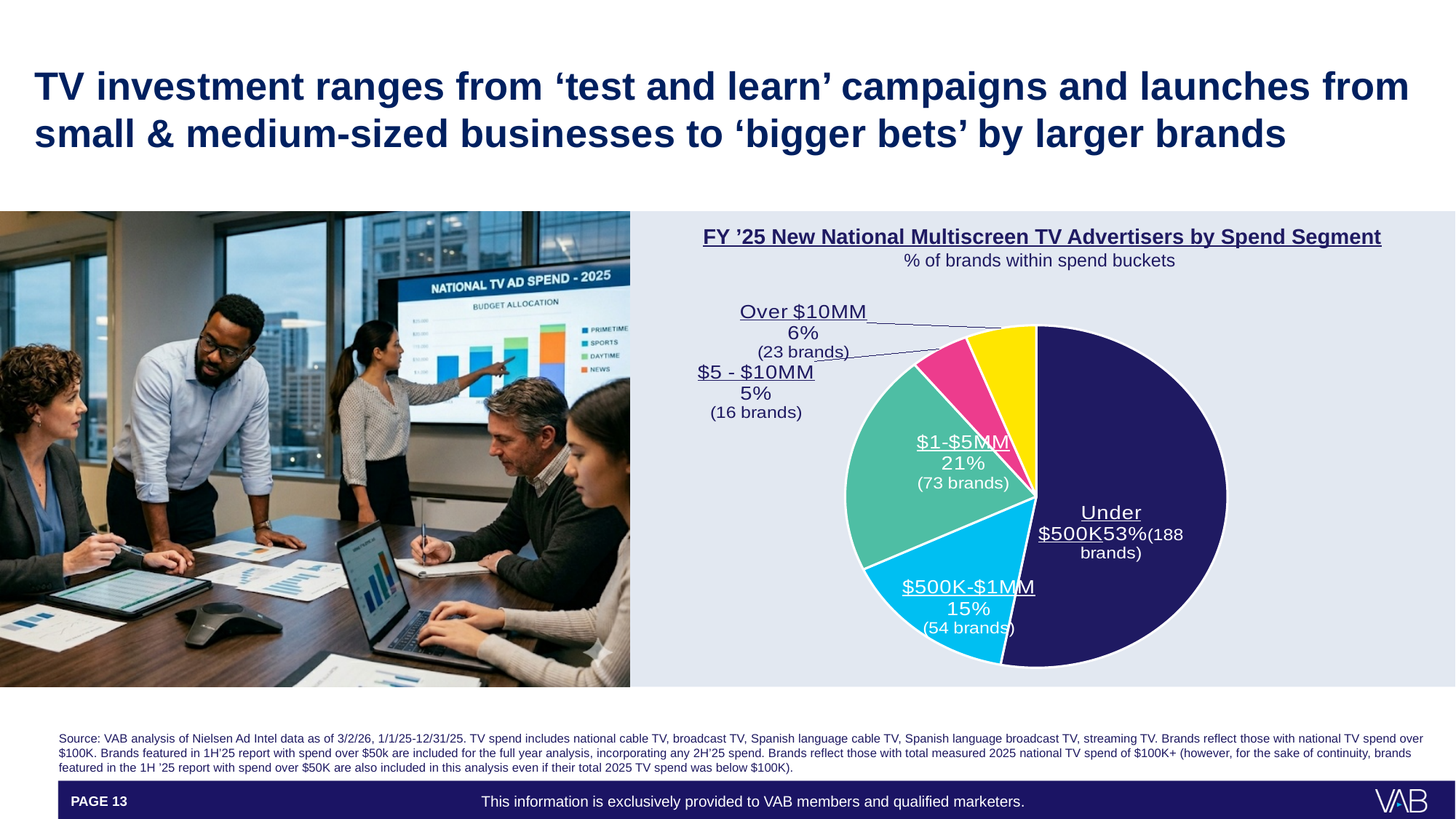
What percentage of brands fall in the $1-$5MM spend segment? 21% What percentage of brands fall in the Under $500K spend segment? 53% How many brands are in the $500K-$1MM spend segment? 54 brands What is the title of the chart? FY '25 New National Multiscreen TV Advertisers by Spend Segment Which spend segment has the smallest share of brands? $5 - $10MM Which spend segment has the largest share of brands? Under $500K How many spend segments are shown in the pie chart? 5 What is the difference in percentage points between the Under $500K and $1-$5MM segments? 32 What is the difference in the number of brands between the $1-$5MM and $5 - $10MM segments? 57 What type of chart is shown on the slide? pie chart Which segment has a larger share: $500K-$1MM or Over $10MM? $500K-$1MM How many brands are in the Over $10MM spend segment? 23 brands